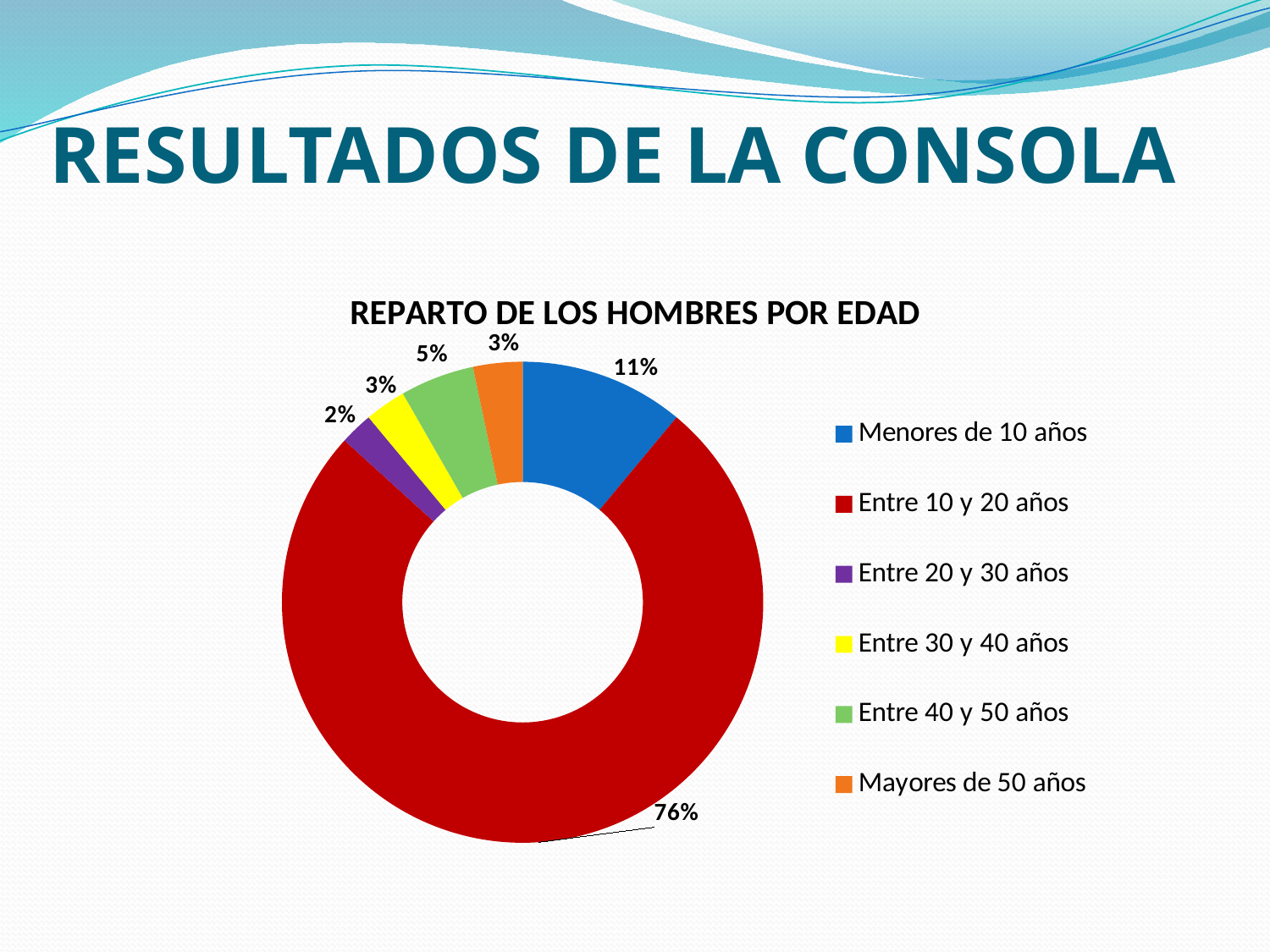
What is the title of the chart on the slide? REPARTO DE LOS HOMBRES POR EDAD What colour represents "Mayores de 50 años" in the chart? orange What percentage is shown for "Menores de 10 años"? 11% What percentage is shown for "Entre 10 y 20 años"? 76% How many age categories does the legend list? 6 What percentage is shown for "Entre 20 y 30 años"? 2% Which age group has the smallest share of the chart? Entre 20 y 30 años What percentage is shown for "Entre 40 y 50 años"? 5% What is the difference in percentage points between "Entre 10 y 20 años" and "Menores de 10 años"? 65 Which age group has the largest share of the chart? Entre 10 y 20 años Which has a larger share, "Entre 40 y 50 años" or "Entre 30 y 40 años"? Entre 40 y 50 años What kind of chart is shown on the slide? doughnut chart